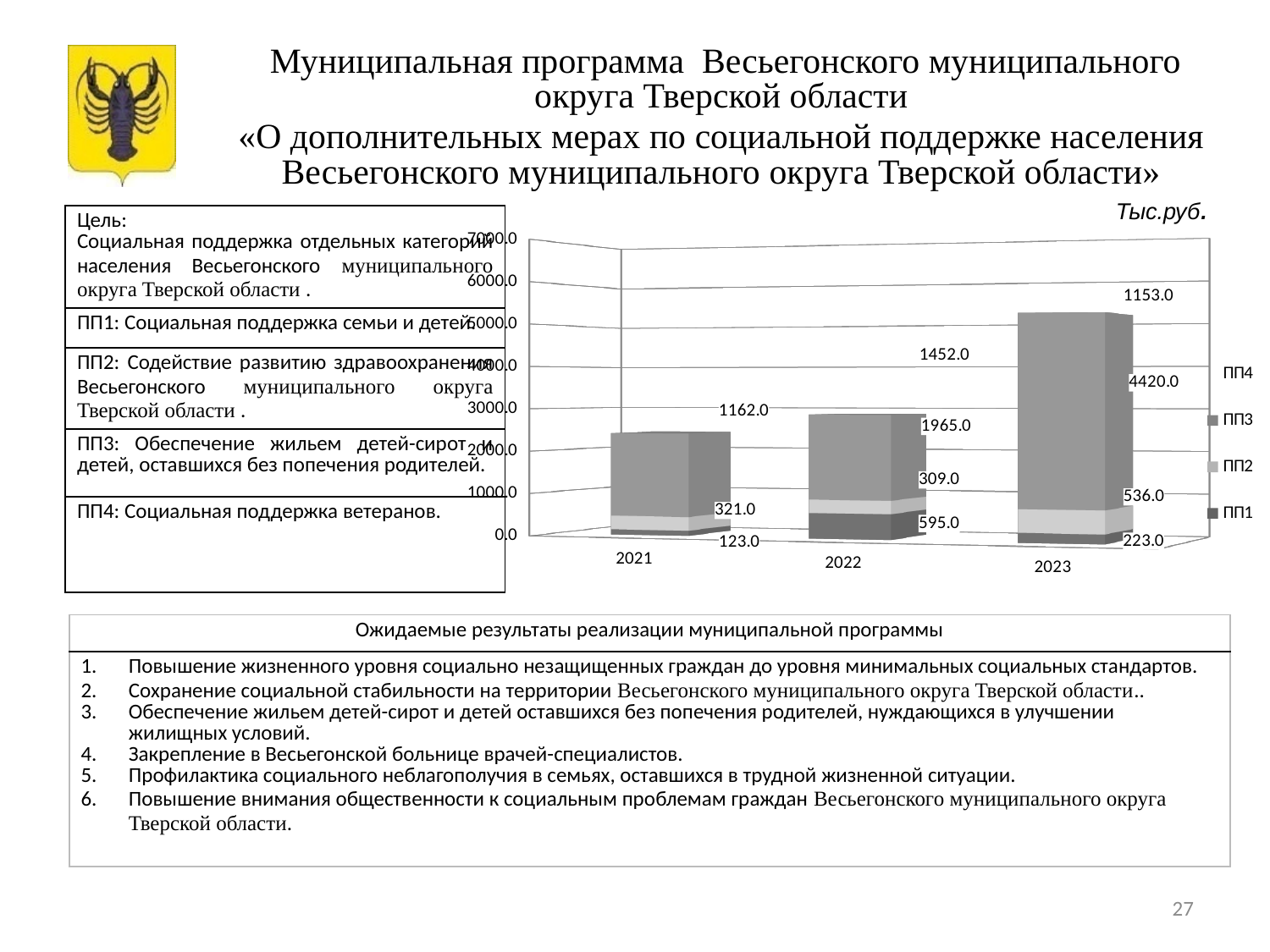
What is the value of ПП3 for 2023? 4420.0 What is the value of ПП4 for 2022? 1452.0 Which year has the tallest stacked bar? 2023 What is the total of the stacked bar for 2023? 6332.0 How many years are shown on the x axis of the chart? 3 What is the difference between the ПП1 values for 2022 and 2023? 372.0 Which year has the shortest stacked bar? 2021 What is the value of ПП2 for 2021? 321.0 What kind of chart is shown on the slide? Stacked bar chart What is the value of ПП1 for 2022? 595.0 Which year has the larger ПП4 value, 2022 or 2023? 2022 How many series does the chart legend list? 4